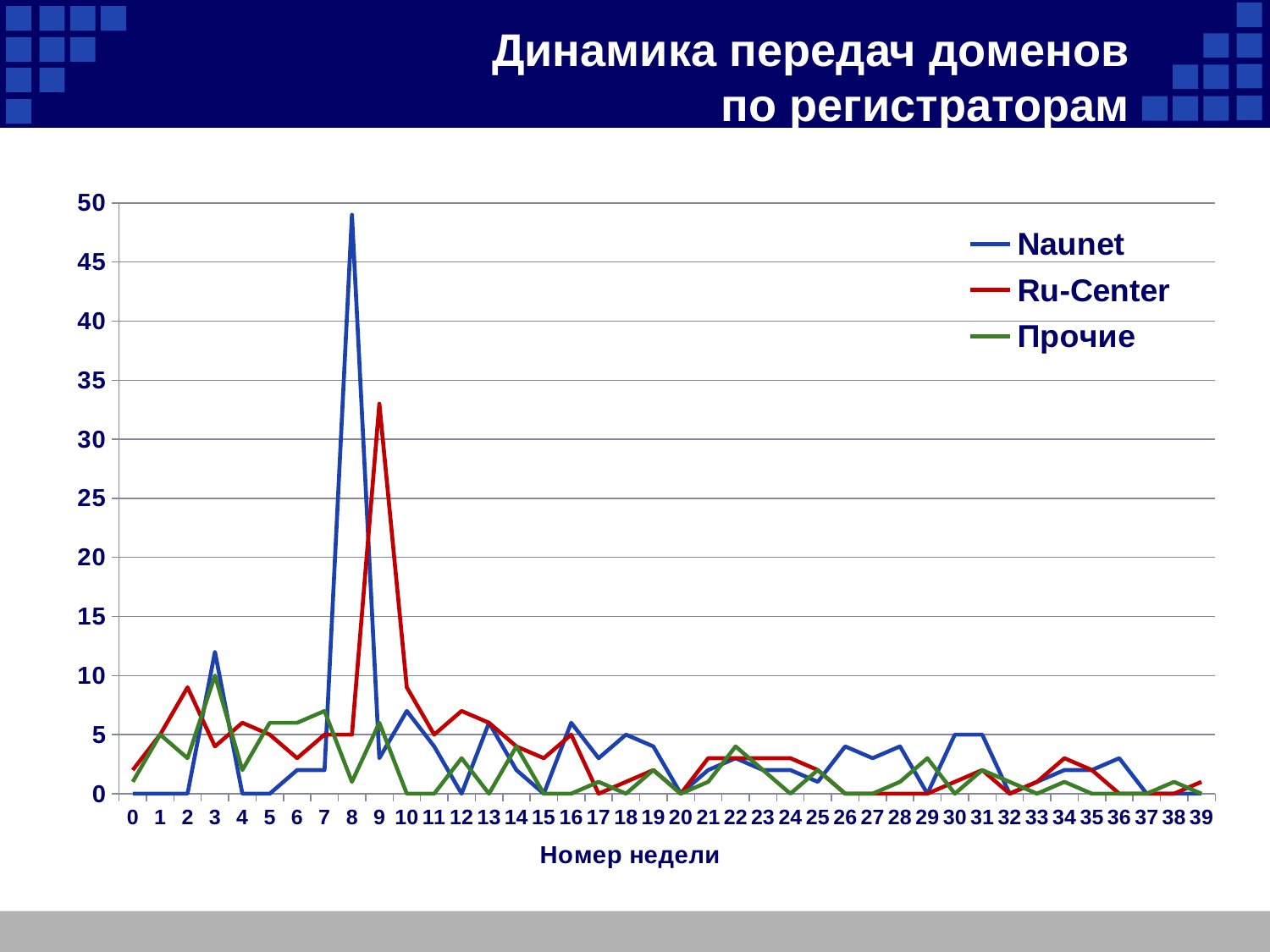
Is the value for Naunet at week 8 greater or less than 45? greater What kind of chart is shown on the slide? line chart How many week numbers are plotted along the x axis? 40 Which is larger at week 8: the Naunet value or the Ru-Center value? Naunet Is the value for Ru-Center at week 9 greater or less than 30? greater Is the value for Ru-Center at week 9 greater or less than 35? less At which week number does the Ru-Center series reach its highest value? 9 What is the value for Naunet at week 0? 0 What is the title of the x axis? Номер недели Which series has the highest peak on the chart? Naunet How many series does the legend list? 3 At which week number does the Naunet series reach its highest value? 8